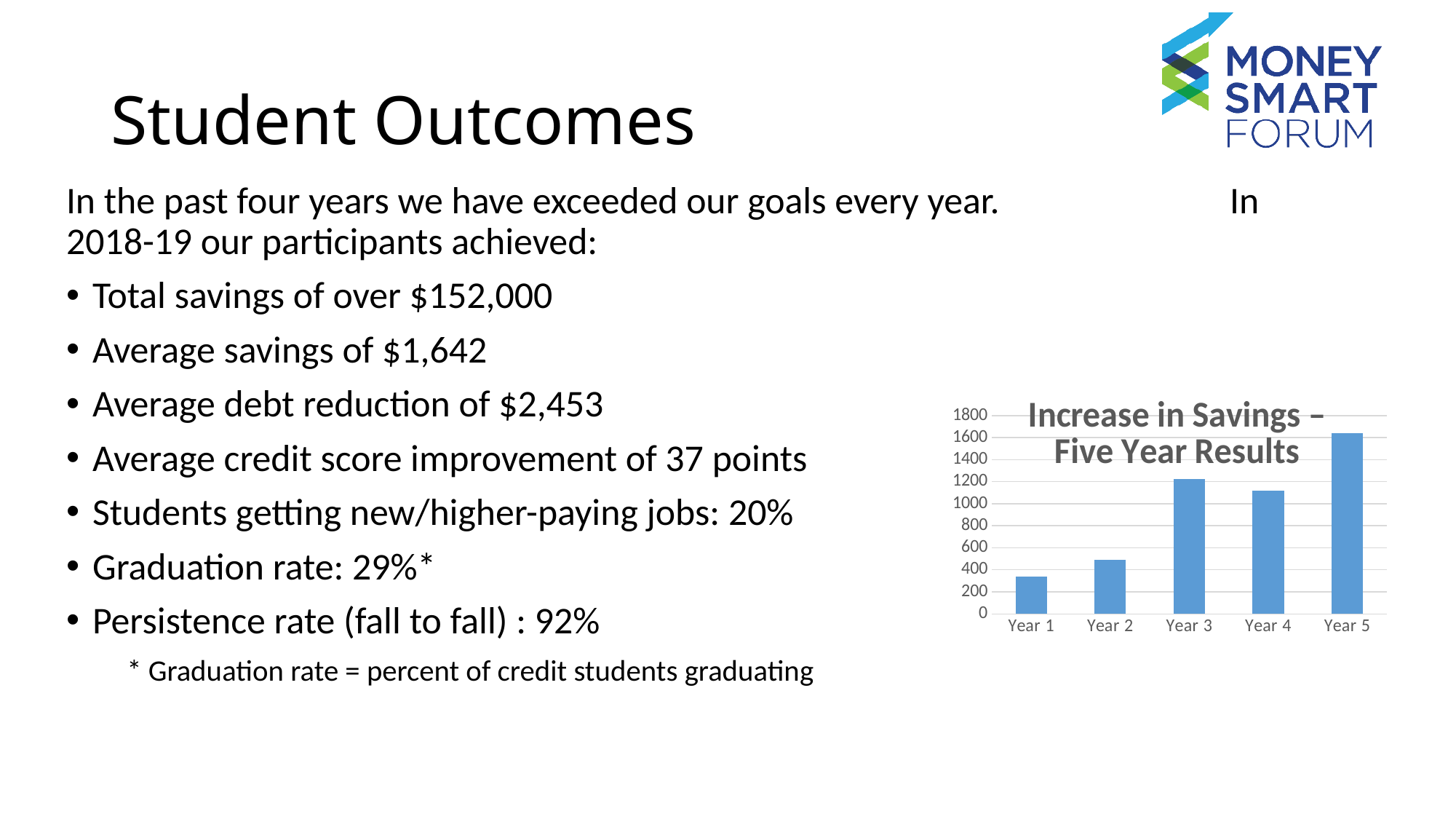
Is the value for Year 3 greater or less than 1000? greater Overall, do the values rise or fall from Year 1 to Year 5? rise Is the value for Year 5 greater or less than 1400? greater Which has the larger value, Year 2 or Year 5? Year 5 Which year has the highest value in the chart? Year 5 Which has the larger value, Year 3 or Year 4? Year 3 Is the value for Year 2 greater or less than 600? less Which year has the lowest value in the chart? Year 1 What kind of chart is shown on the slide? bar chart How many years (categories) are plotted in the chart? 5 What is the title of the chart? Increase in Savings – Five Year Results